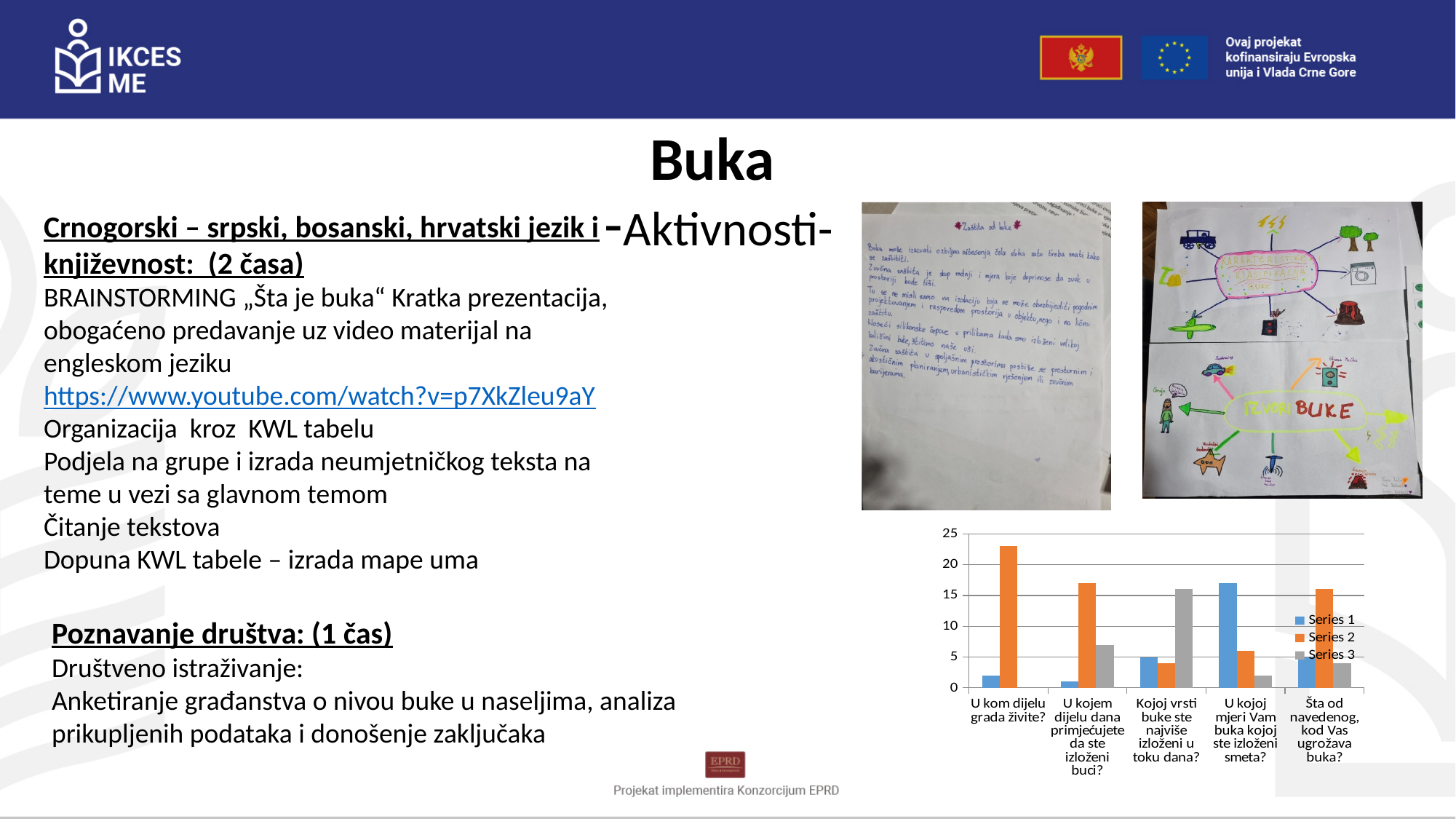
What colour are the Series 2 bars in the chart? orange For "Šta od navedenog, kod Vas ugrožava buka?", which is larger: Series 2 or Series 3? Series 2 Which category has the highest Series 2 value? U kom dijelu grada živite? For "U kojoj mjeri Vam buka kojoj ste izloženi smeta?", which is larger: Series 1 or Series 2? Series 1 How many categories are shown on the x axis of the chart? 5 Which series has the highest value for "Kojoj vrsti buke ste najviše izloženi u toku dana?" Series 3 Is the Series 1 value for "U kojoj mjeri Vam buka kojoj ste izloženi smeta?" greater or less than 15? greater Is the Series 2 value for "U kom dijelu grada živite?" greater or less than 20? greater Is the Series 3 value for "U kojem dijelu dana primjećujete da ste izloženi buci?" greater or less than 10? less How many series does the chart legend list? 3 What kind of chart is shown on the slide? bar chart